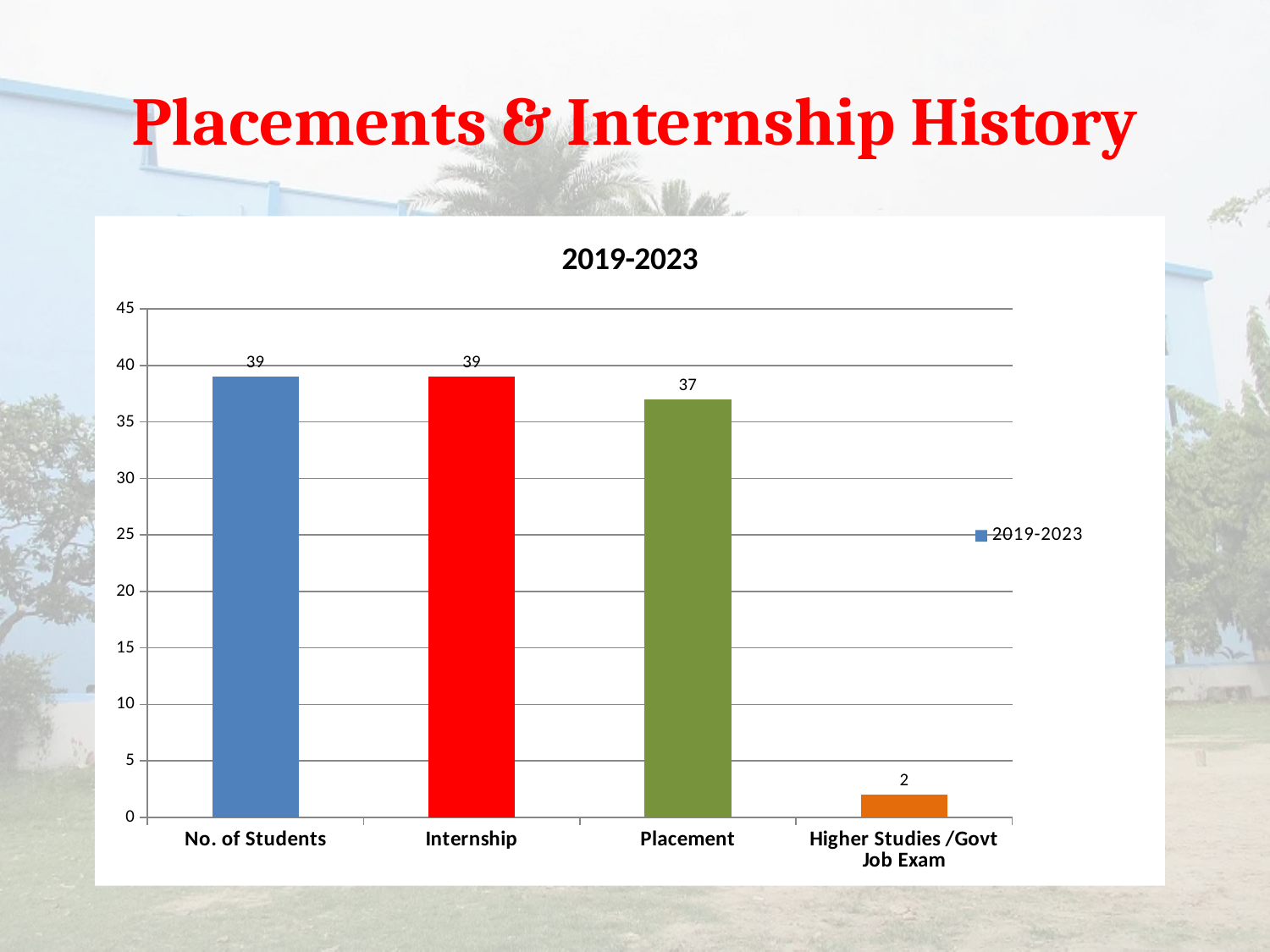
What is the value for Higher Studies /Govt Job Exam? 2 How many categories are shown on the x axis? 4 What is the difference between the values for Internship and Placement? 2 What is the difference between the values for No. of Students and Higher Studies /Govt Job Exam? 37 What is the value for Internship? 39 What is the value for Placement? 37 What is the title of the chart? 2019-2023 Is the value for Placement greater or less than 35? greater What kind of chart is shown on the slide? bar chart How many series does the legend list? 1 Which is larger, the value for Placement or the value for Higher Studies /Govt Job Exam? Placement Which category has the lowest value? Higher Studies /Govt Job Exam